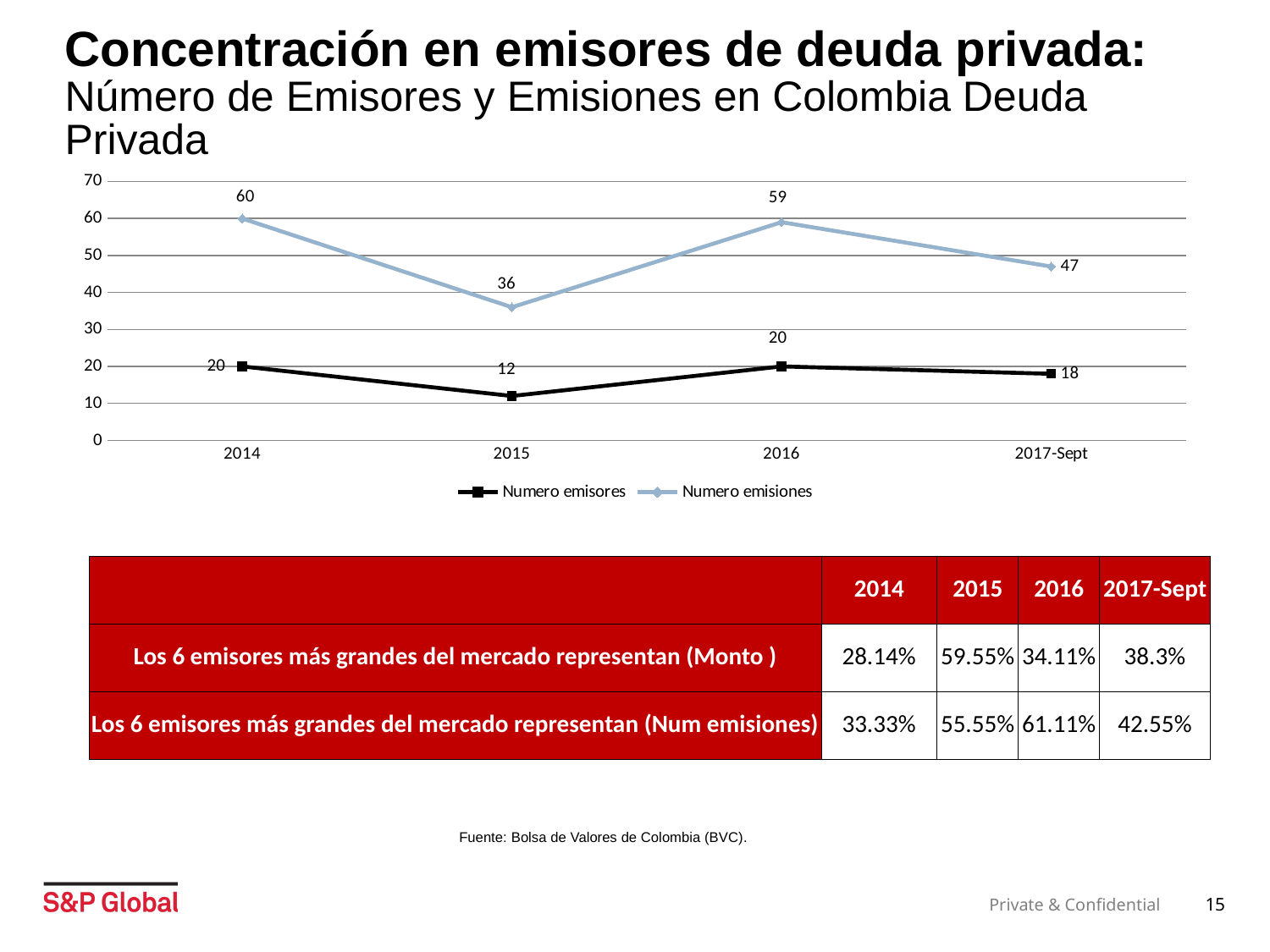
What kind of chart is shown on the slide? Line chart What is the value of Numero emisiones in 2014? 60 What is the difference between Numero emisiones and Numero emisores in 2016? 39 What is the value of Numero emisores in 2016? 20 In which year is Numero emisores lowest? 2015 What is the value of Numero emisiones in 2017-Sept? 47 Does Numero emisiones rise or fall from 2015 to 2016? Rise How many series does the legend list? 2 What is the value of Numero emisores in 2015? 12 In which year is Numero emisiones highest? 2014 How many points are plotted along the x axis for each series? 4 Which is larger: Numero emisiones in 2015 or Numero emisiones in 2017-Sept? 2017-Sept